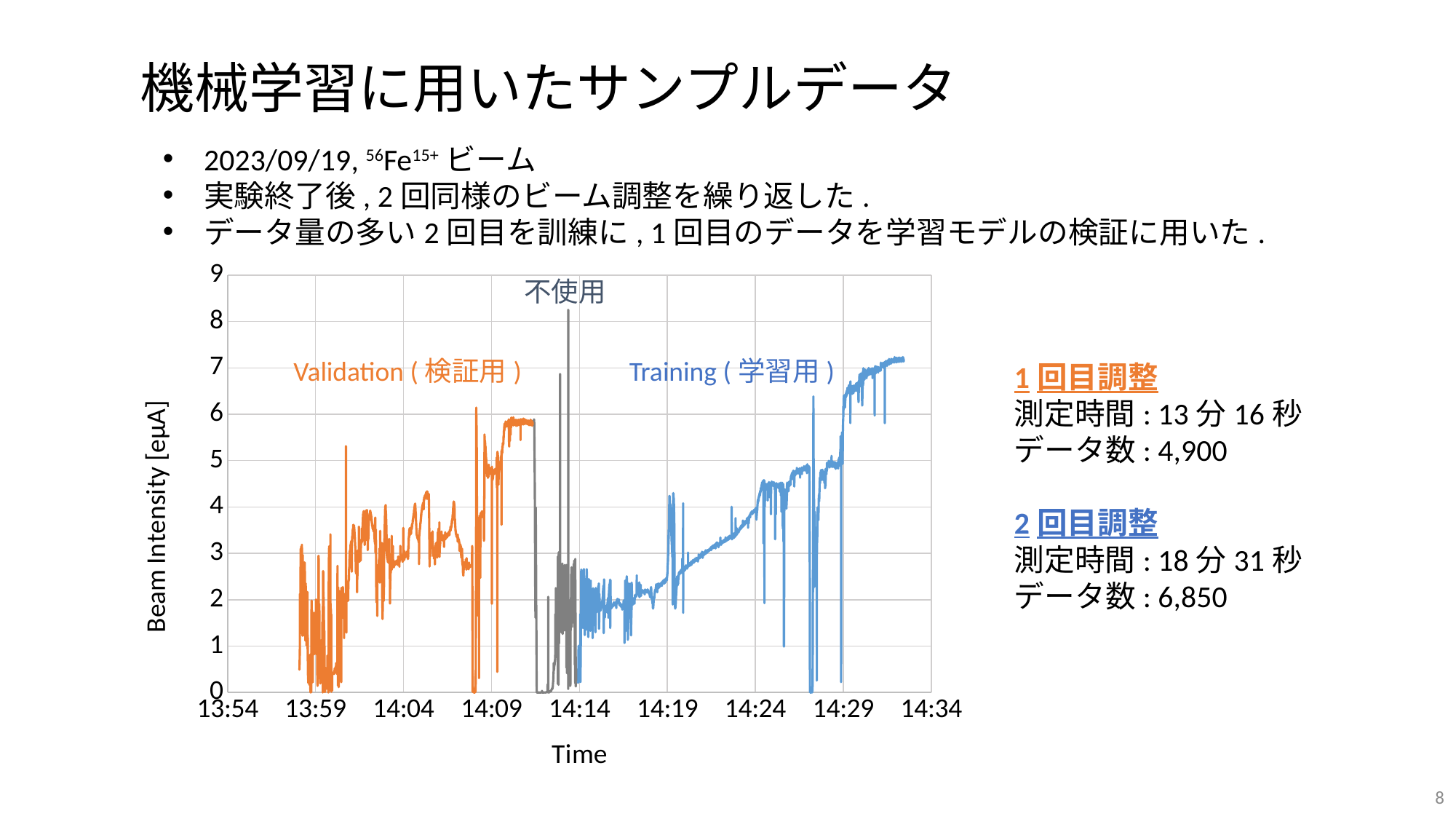
How many tick labels are shown on the x axis of the chart? 9 Is the beam intensity at 14:19 greater or less than 5? less What kind of chart is shown on the slide? line chart How many labelled segments does the chart show? 3 Is the highest value in the Validation ( 検証用 ) segment greater or less than 7? less What is the label of the y axis of the chart? Beam Intensity [eμA] Which segment of the chart is drawn in orange? Validation ( 検証用 ) What is the highest value shown on the y axis of the chart? 9 Which segment reaches a higher maximum beam intensity, Validation ( 検証用 ) or Training ( 学習用 )? Training ( 学習用 ) Does the beam intensity in the Training ( 学習用 ) segment generally rise or fall from 14:14 to 14:34? rise Is the highest value in the Training ( 学習用 ) segment greater or less than 6? greater